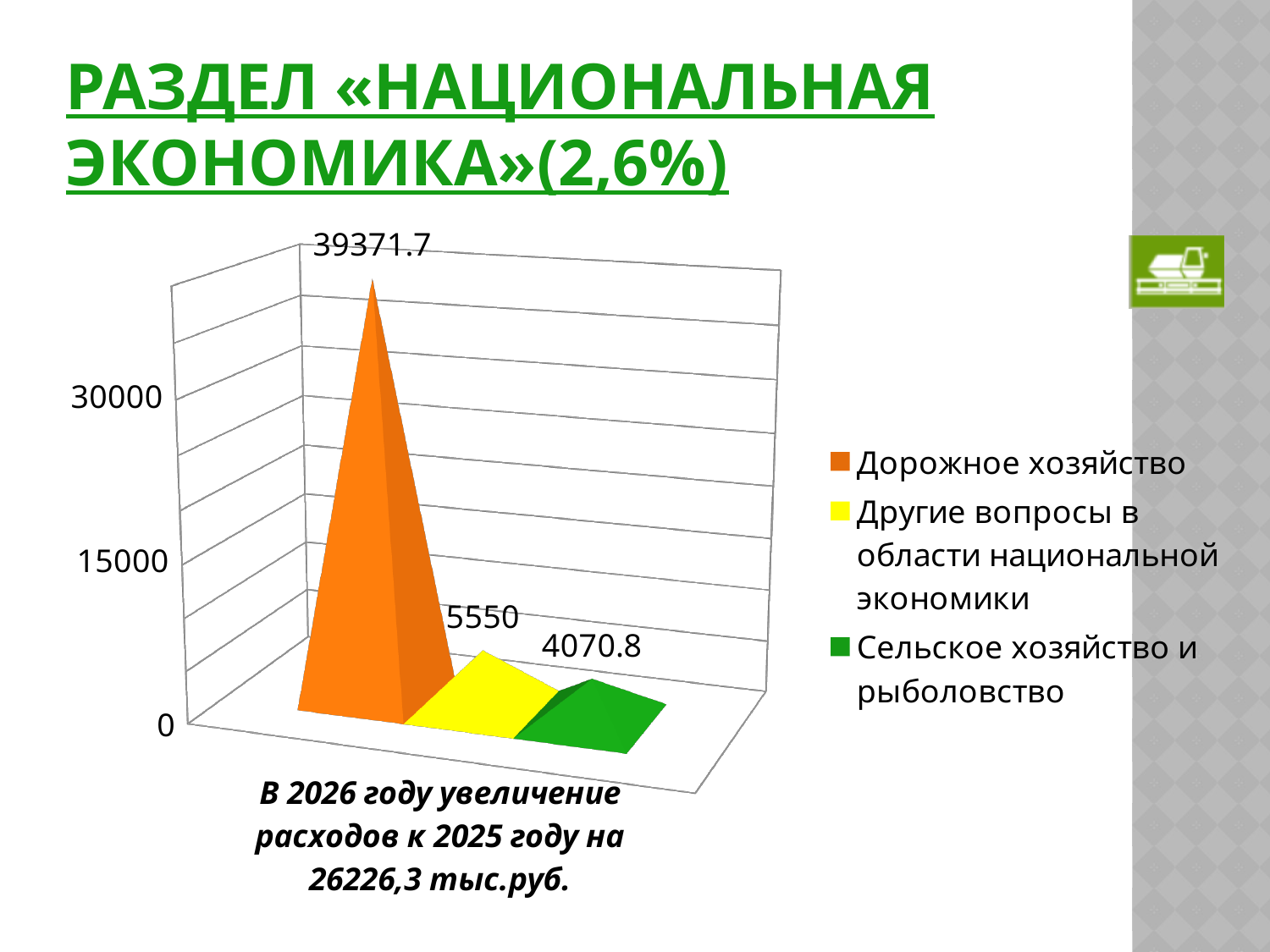
What kind of chart is shown on the slide? bar chart What is the value for Дорожное хозяйство? 39371.7 What is the value for Сельское хозяйство и рыболовство? 4070.8 What colour represents Дорожное хозяйство in the chart? orange What is the difference between the values for Дорожное хозяйство and Другие вопросы в области национальной экономики? 33821.7 Which is larger, the value for Другие вопросы в области национальной экономики or the value for Сельское хозяйство и рыболовство? Другие вопросы в области национальной экономики What is the value for Другие вопросы в области национальной экономики? 5550 Which series has the highest value? Дорожное хозяйство What is the difference between the values for Другие вопросы в области национальной экономики and Сельское хозяйство и рыболовство? 1479.2 Is the value for Дорожное хозяйство greater or less than 30000? greater Which series has the lowest value? Сельское хозяйство и рыболовство How many series does the legend list? 3